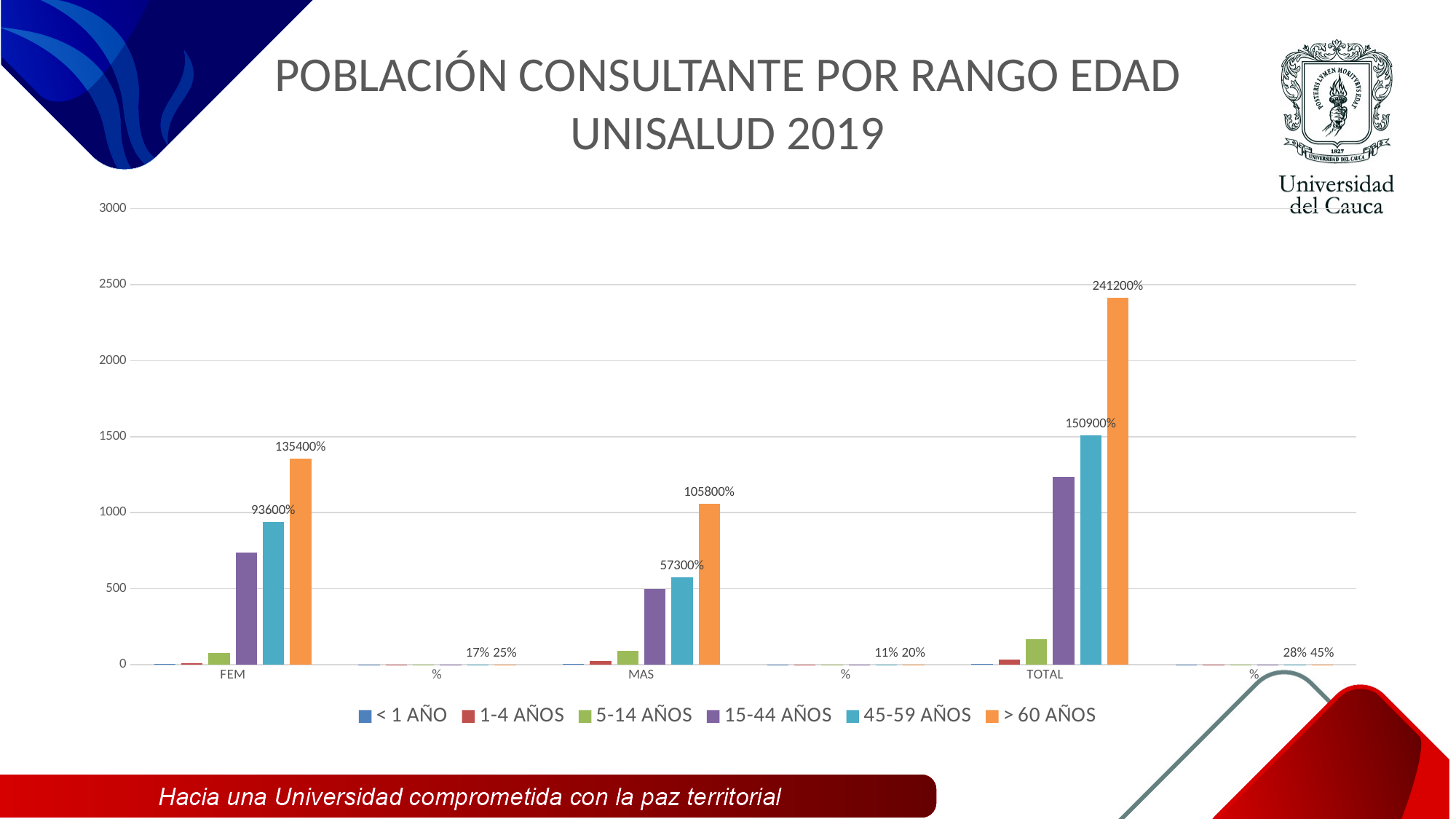
How many categories are shown along the x axis? 6 What data label is shown on the 45-59 AÑOS bar for MAS? 57300% What data label is shown on the > 60 AÑOS bar for TOTAL? 241200% What is the title of the chart on the slide? POBLACIÓN CONSULTANTE POR RANGO EDAD UNISALUD 2019 What kind of chart is shown on the slide? bar chart How many series does the legend list? 6 Is the value of the 15-44 AÑOS bar for TOTAL greater or less than 1000? greater Which is larger for the > 60 AÑOS series: FEM or MAS? FEM Which series has the tallest bar in the TOTAL category? > 60 AÑOS Is the value of the 15-44 AÑOS bar for FEM greater or less than 500? greater What data label is shown on the > 60 AÑOS bar for MAS? 105800% What data label is shown on the 45-59 AÑOS bar for FEM? 93600%